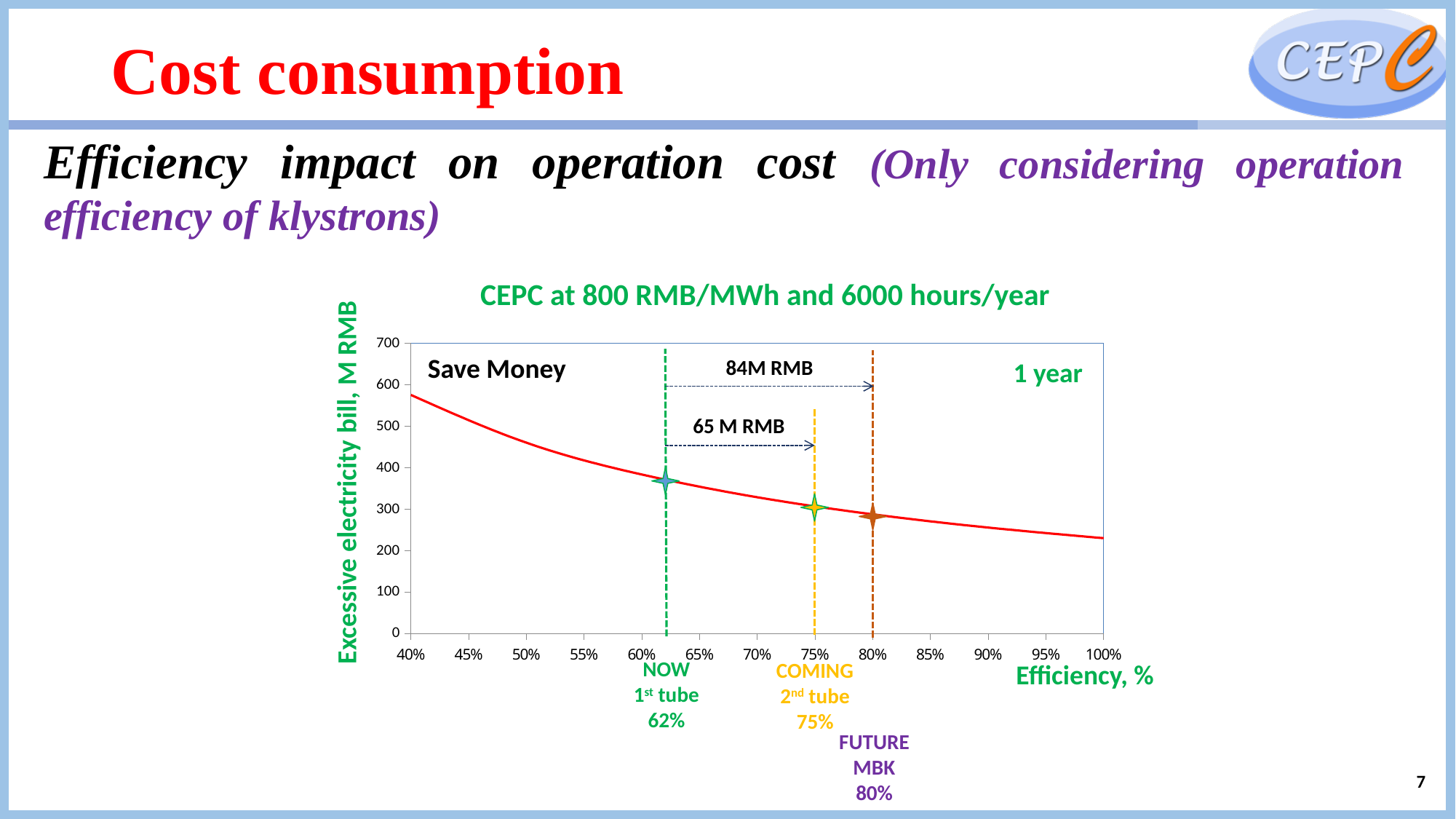
What kind of chart is shown on the slide? line chart According to the chart annotation, how much money is saved per year by going from the NOW 1st tube (62%) to the FUTURE MBK (80%)? 84M RMB What efficiency is marked for the NOW 1st tube on the chart? 62% Is the excessive electricity bill at 100% efficiency greater or less than 300 M RMB? less Which has the larger excessive electricity bill: the NOW 1st tube at 62% or the FUTURE MBK at 80%? NOW 1st tube at 62% According to the chart annotation, how much money is saved per year by going from the NOW 1st tube (62%) to the COMING 2nd tube (75%)? 65 M RMB Is the excessive electricity bill at 40% efficiency greater or less than 500 M RMB? greater Does the excessive electricity bill rise or fall as efficiency increases along the x axis? fall What is the label of the vertical axis of the chart? Excessive electricity bill, M RMB What is the title of the chart? CEPC at 800 RMB/MWh and 6000 hours/year What efficiency is marked for the FUTURE MBK on the chart? 80% Is the excessive electricity bill at 62% efficiency greater or less than 300 M RMB? greater